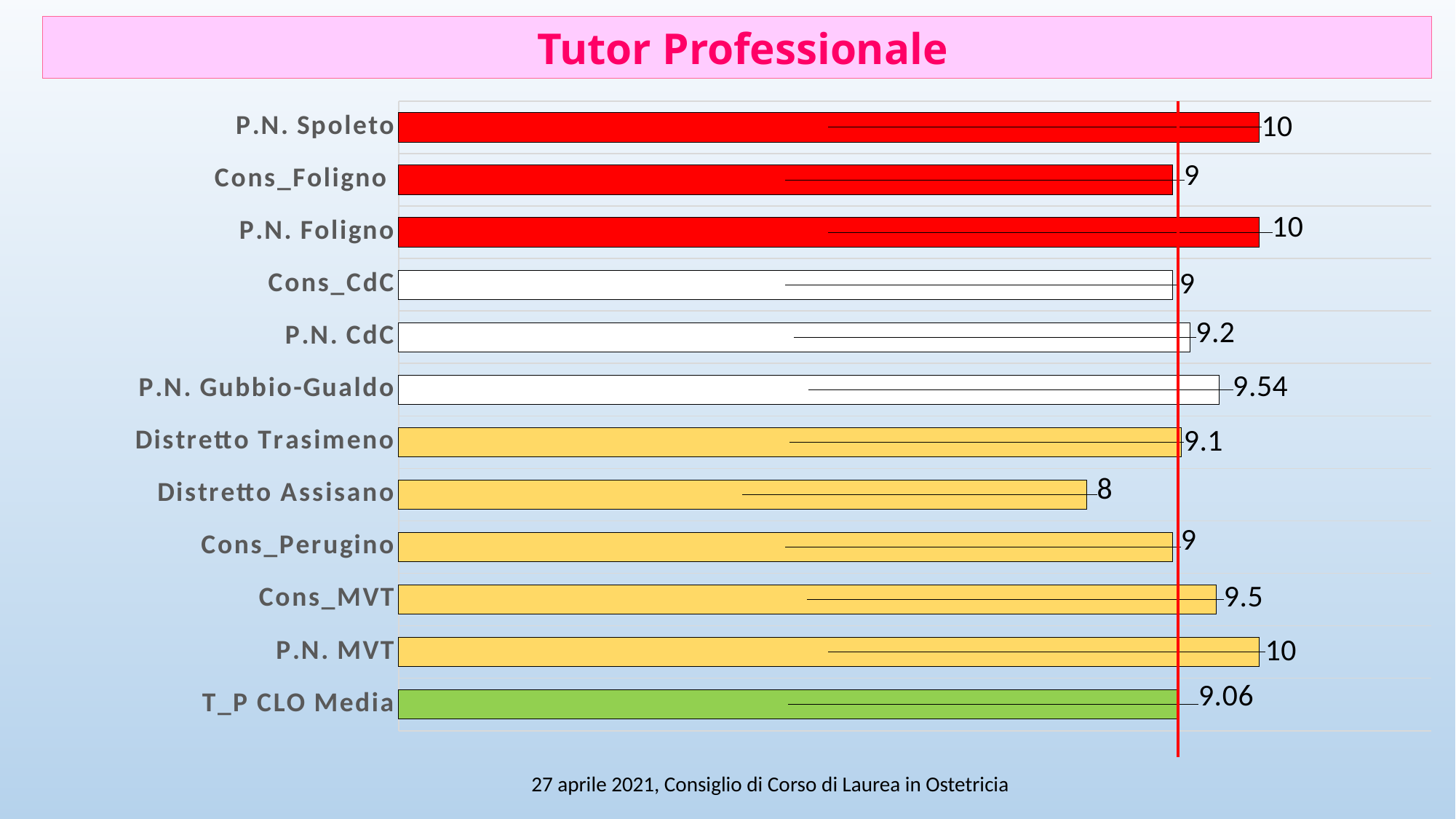
Which is larger, the value for P.N. CdC or the value for Cons_CdC? P.N. CdC What is the value for Distretto Assisano? 8 Which category has the lowest value? Distretto Assisano What is the difference between the values for P.N. Spoleto and Distretto Assisano? 2 What is the value for T_P CLO Media? 9.06 How many categories are shown in the chart? 12 What is the value for Cons_MVT? 9.5 What is the title of the chart? Tutor Professionale What kind of chart is shown on the slide? Bar chart Which is larger, the value for Cons_MVT or the value for Distretto Trasimeno? Cons_MVT What is the value for P.N. Gubbio-Gualdo? 9.54 What is the difference between the values for P.N. Gubbio-Gualdo and P.N. CdC? 0.34